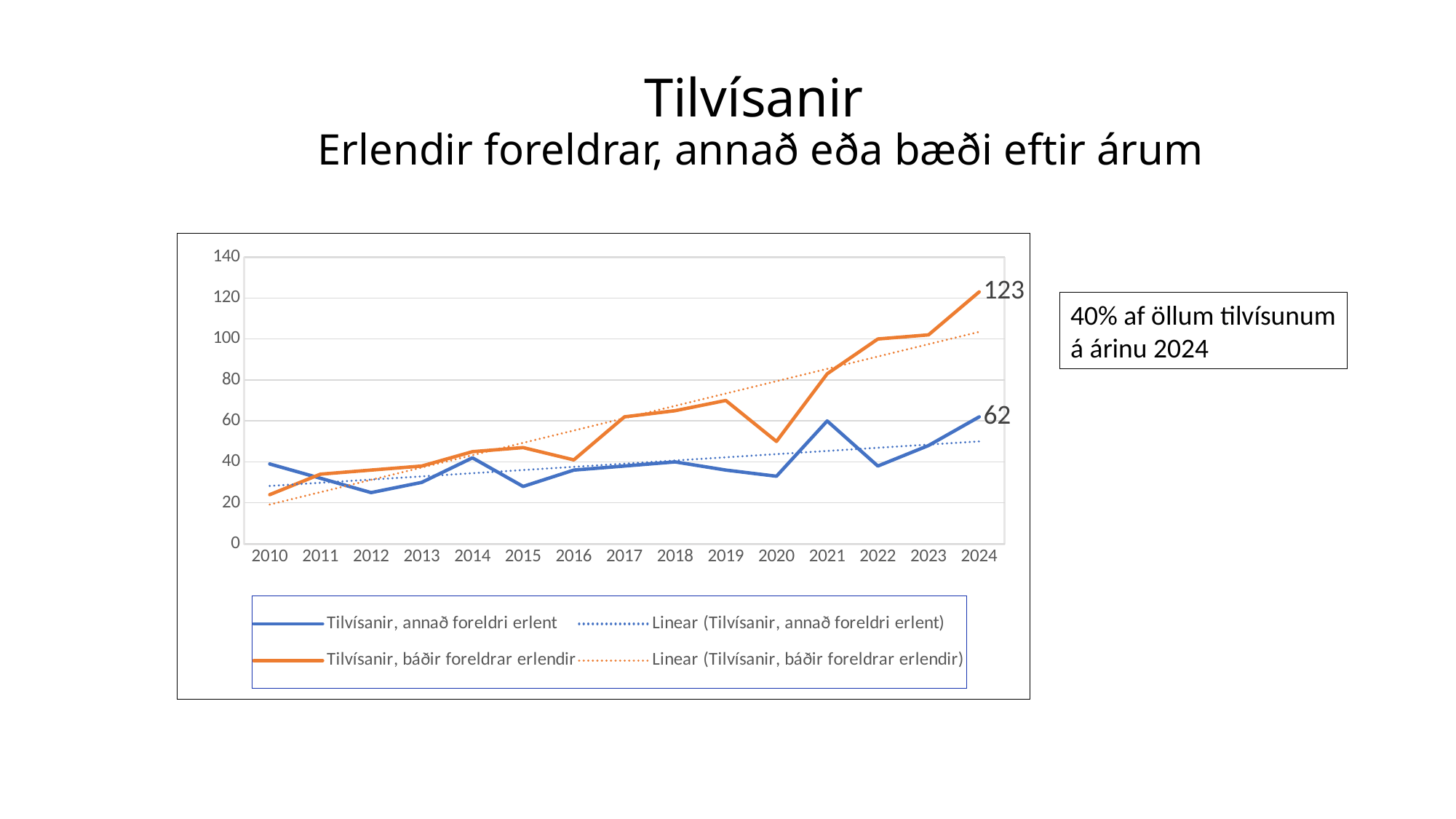
What is the difference between the 2024 values of "Tilvísanir, báðir foreldrar erlendir" and "Tilvísanir, annað foreldri erlent"? 61 What is the value for "Tilvísanir, báðir foreldrar erlendir" in 2024? 123 In which year does "Tilvísanir, báðir foreldrar erlendir" reach its highest value? 2024 How many entries does the chart legend list? 4 What is the value for "Tilvísanir, annað foreldri erlent" in 2024? 62 Is the value for "Tilvísanir, annað foreldri erlent" in 2021 greater or less than 40? greater Is the value for "Tilvísanir, báðir foreldrar erlendir" in 2020 greater or less than 60? less How many years are shown on the x axis of the chart? 15 What kind of chart is shown on the slide? line chart In 2024, which series has the larger value: "Tilvísanir, annað foreldri erlent" or "Tilvísanir, báðir foreldrar erlendir"? Tilvísanir, báðir foreldrar erlendir Is the value for "Tilvísanir, báðir foreldrar erlendir" in 2010 greater or less than 40? less Do the values for "Tilvísanir, báðir foreldrar erlendir" generally rise or fall from 2010 to 2024? rise